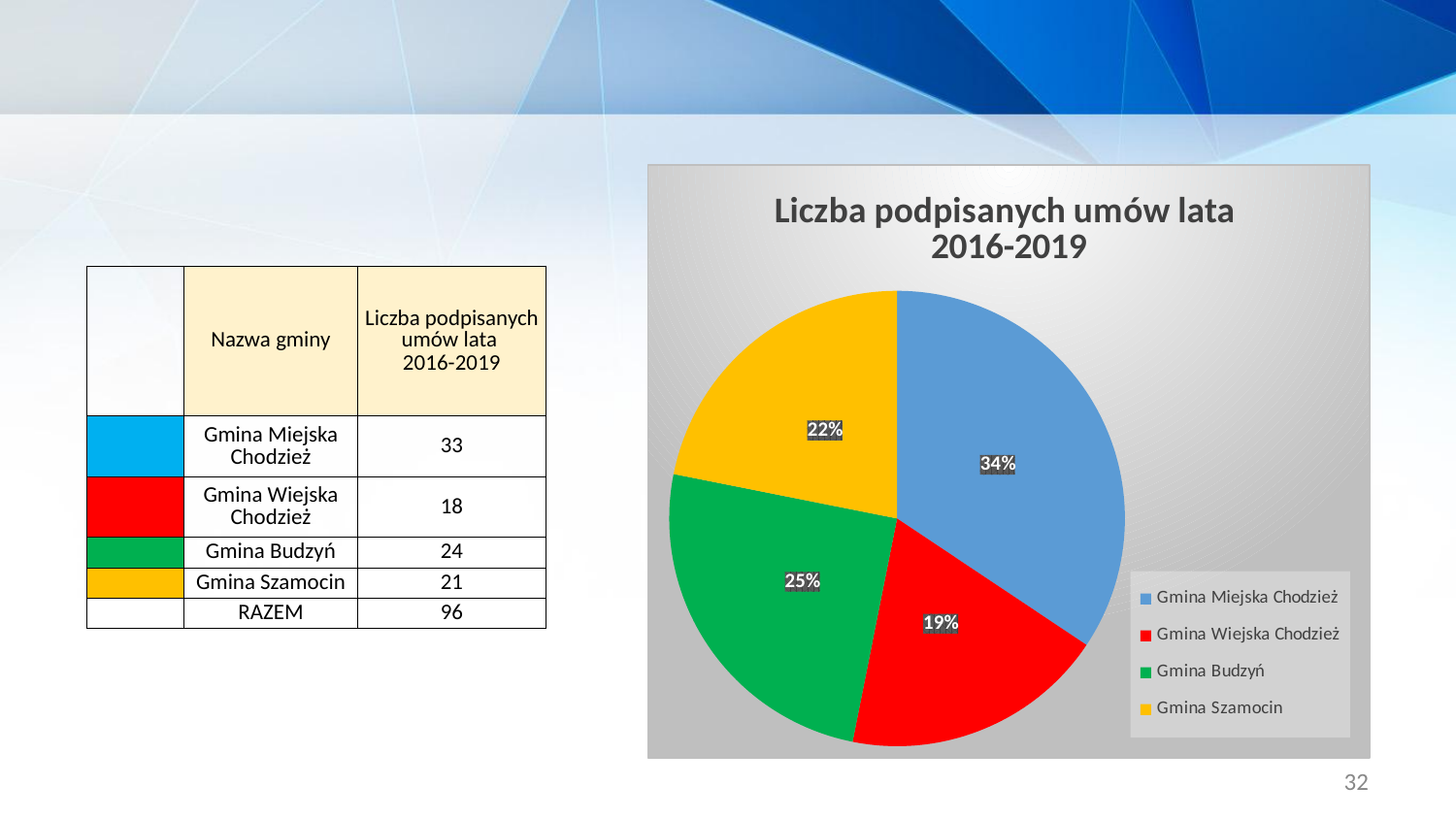
What colour is the slice for Gmina Budzyń in the pie chart? green Which slice is larger, Gmina Budzyń or Gmina Szamocin? Gmina Budzyń Which category has the largest slice of the pie? Gmina Miejska Chodzież What share of the pie does Gmina Miejska Chodzież have? 34% What share of the pie does Gmina Szamocin have? 22% How many slices does the pie chart have? 4 What share of the pie does Gmina Budzyń have? 25% What type of chart is shown on the slide? pie chart Which category has the smallest slice of the pie? Gmina Wiejska Chodzież What is the title of the pie chart? Liczba podpisanych umów lata 2016-2019 How many entries does the legend of the pie chart list? 4